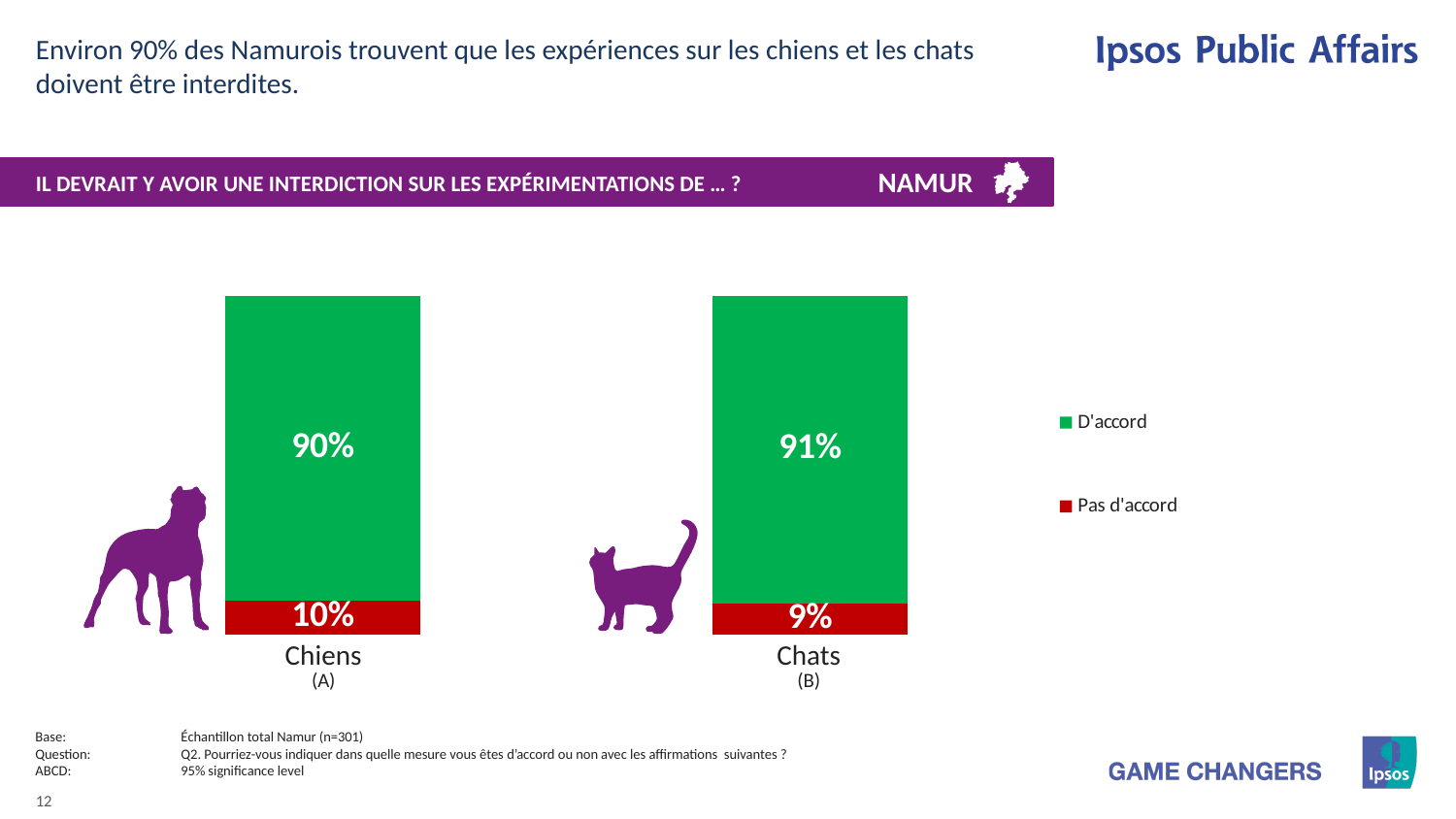
How many categories are shown on the x axis of the chart? 2 What percentage of respondents agree (D'accord) that experiments on dogs (Chiens) should be banned? 90% What is the difference between the 'D'accord' values for Chats and Chiens? 1% What is the 'Pas d'accord' value for Chiens? 10% Which category has the lower 'Pas d'accord' share? Chats What percentage of respondents agree (D'accord) that experiments on cats (Chats) should be banned? 91% What is the 'Pas d'accord' value for Chats? 9% How many series does the legend list? 2 What kind of chart is shown on the slide? Stacked bar chart Which category has the higher 'D'accord' share, Chiens or Chats? Chats Which colour represents 'Pas d'accord' in the chart? Red What is the total of the stacked bar for Chiens? 100%